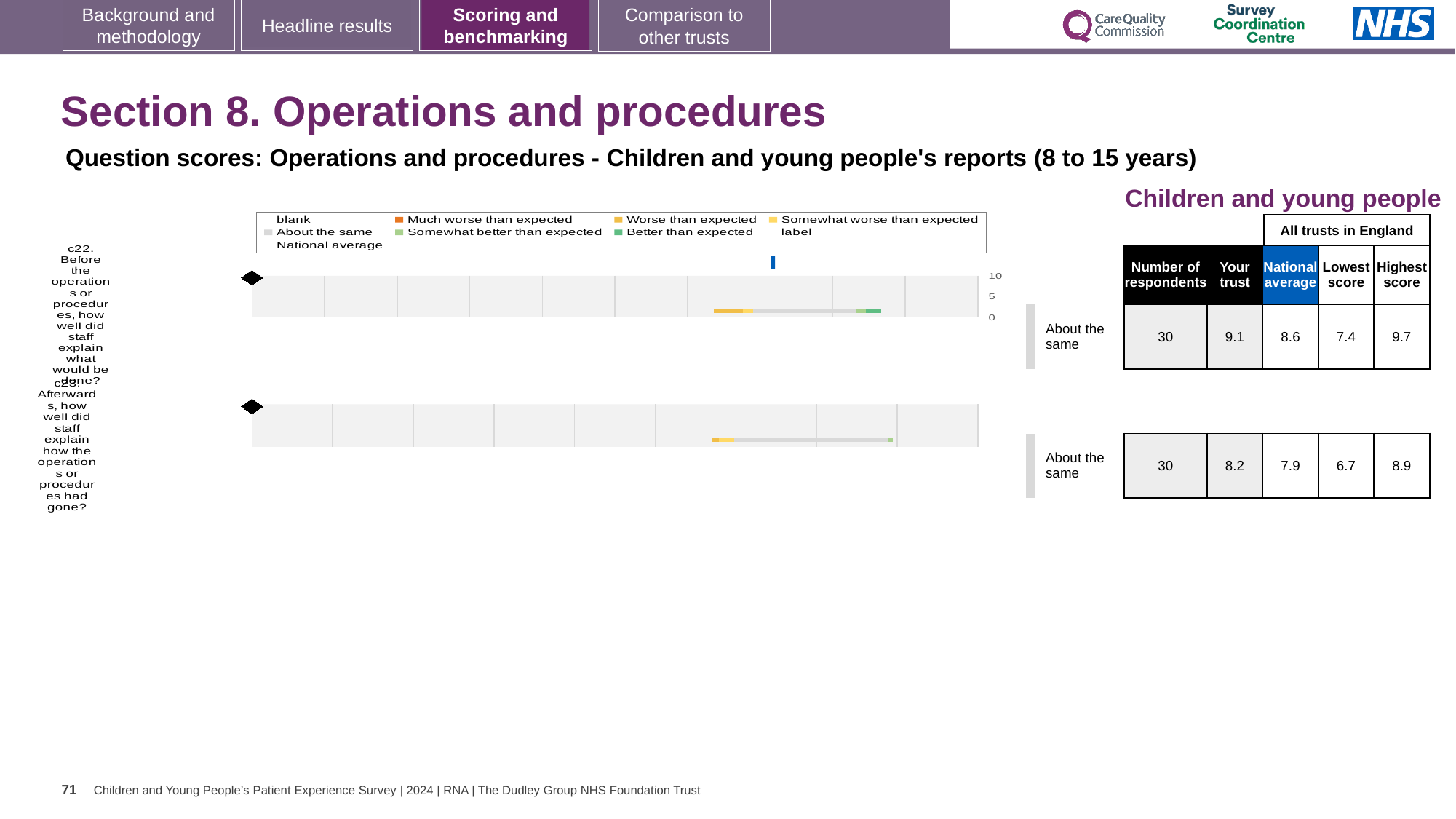
What is the 'Your trust' score for c22 (Before the operations or procedures, how well did staff explain what would be done?)? 9.1 For c23, which is higher: the trust score or the national average? the trust score What is the highest score among all trusts in England for c23? 8.9 What is the 'Your trust' score for c23 (Afterwards, how well did staff explain how the operations or procedures had gone?)? 8.2 What is the lowest score among all trusts in England for c22? 7.4 What is the national average score for c22? 8.6 What benchmarking category is shown for both c22 and c23? About the same How many respondents answered c23? 30 How many questions (c22 and c23) are plotted on the slide? 2 Which legend entry is shown in dark green? Better than expected What is the difference between the trust score and the national average for c22? 0.5 What kind of chart is used to show the question scores for c22 and c23? bar chart